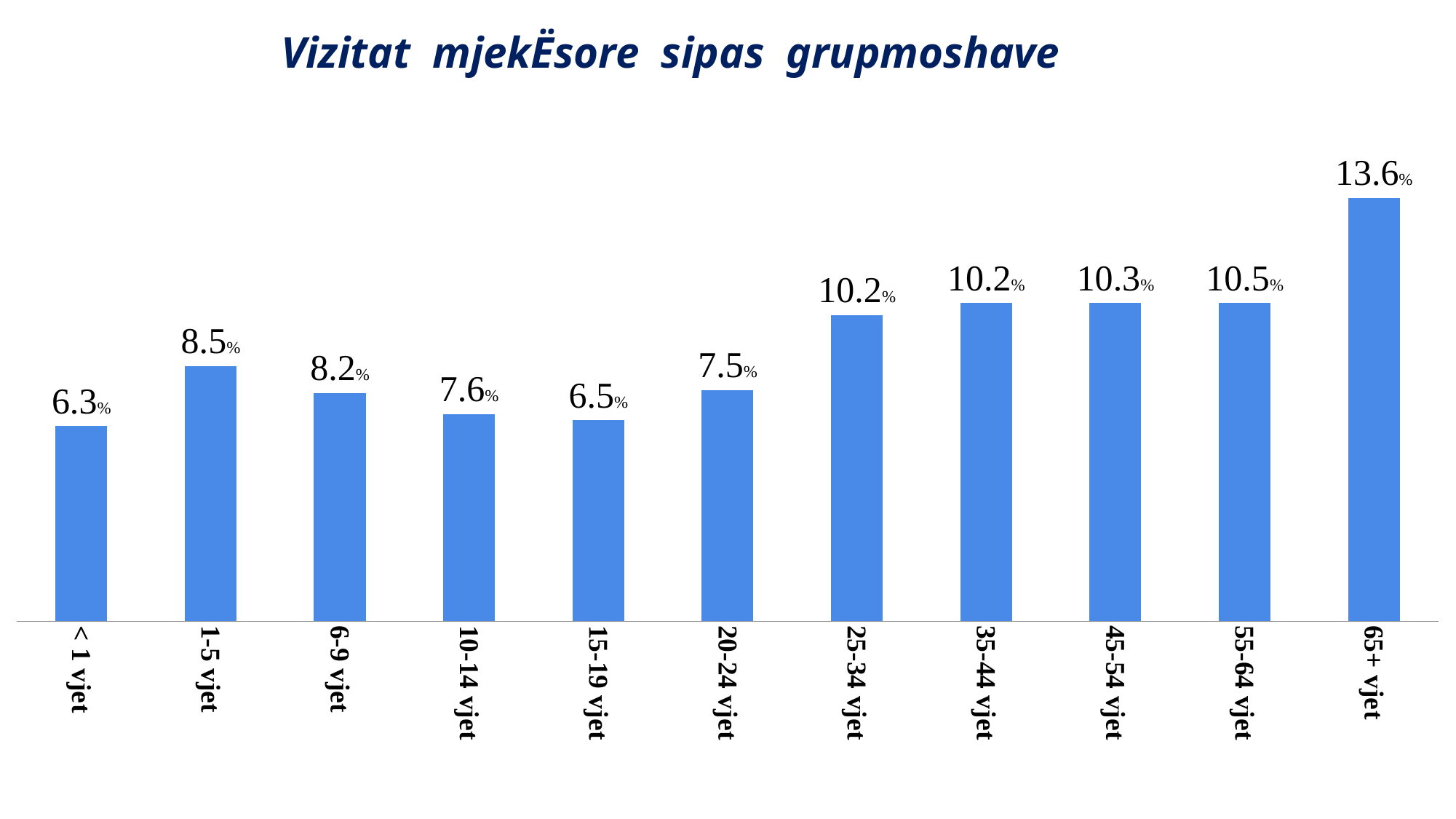
What is the title of the chart? Vizitat mjekËsore sipas grupmoshave What is the difference between the values for 65+ vjet and 55-64 vjet? 3.1% How many age groups are shown in the chart? 11 What is the value for the 45-54 vjet age group? 10.3% What is the value for the 1-5 vjet age group? 8.5% Which age group has the lowest value? < 1 vjet Which age group has the highest value? 65+ vjet What is the difference between the values for 1-5 vjet and 6-9 vjet? 0.3% What kind of chart is shown on the slide? Bar chart What is the value for the 15-19 vjet age group? 6.5% What is the value for the 65+ vjet age group? 13.6%